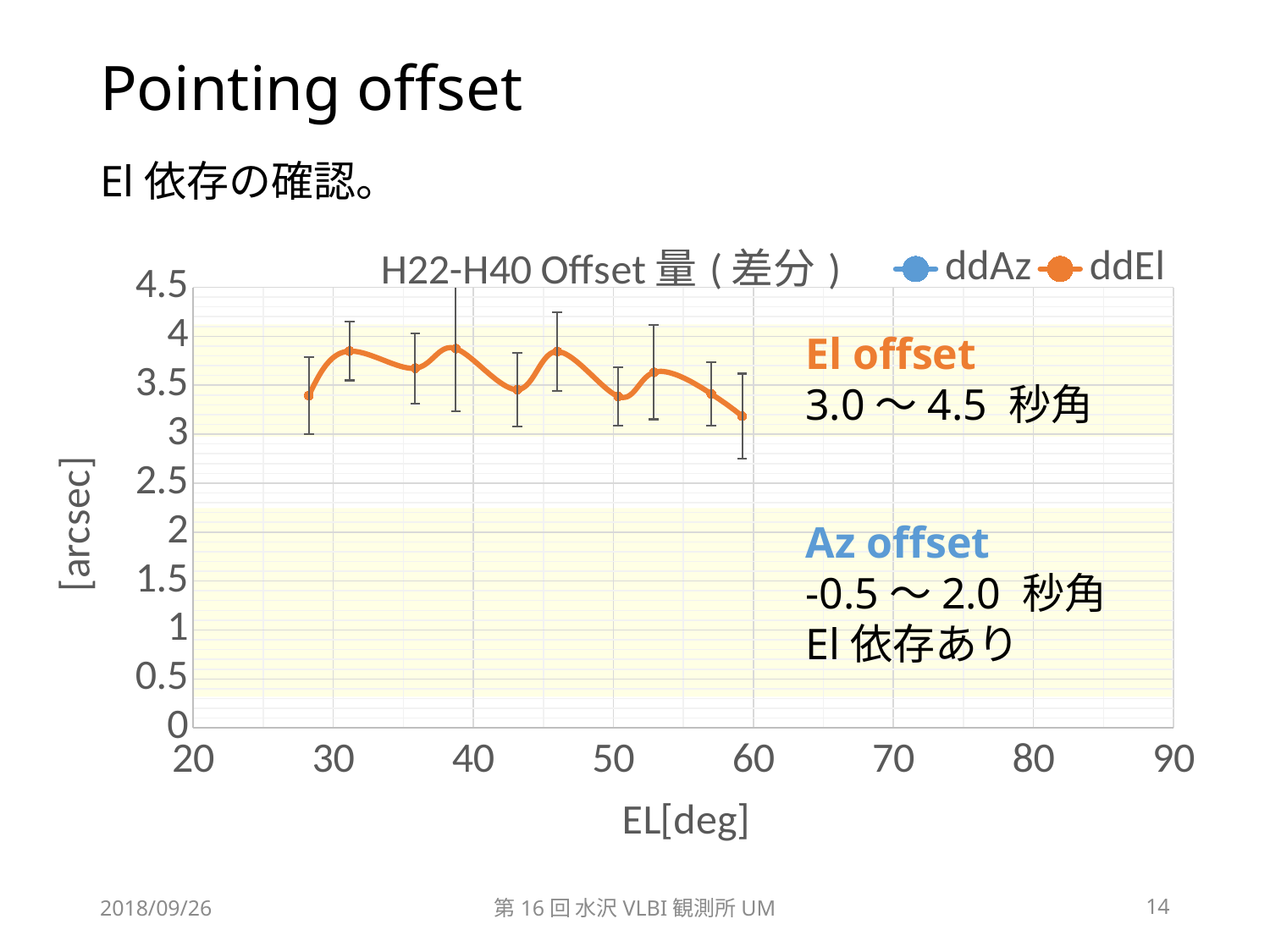
What is the title of the chart? H22-H40 Offset 量（差分） Is the ddEl value at about EL 31 deg greater or less than 3.5 arcsec? greater Are all plotted ddEl values greater or less than 2.5 arcsec? greater How many data points are plotted for the ddEl series? 10 What are the two series names in the chart legend? ddAz and ddEl Does the ddEl line rise or fall between EL 53 deg and EL 59 deg? fall What is the maximum value shown on the y axis? 4.5 How many series does the chart legend list? 2 What kind of chart is shown on the slide? line chart Is the ddEl value at about EL 59 deg greater or less than 3.5 arcsec? less